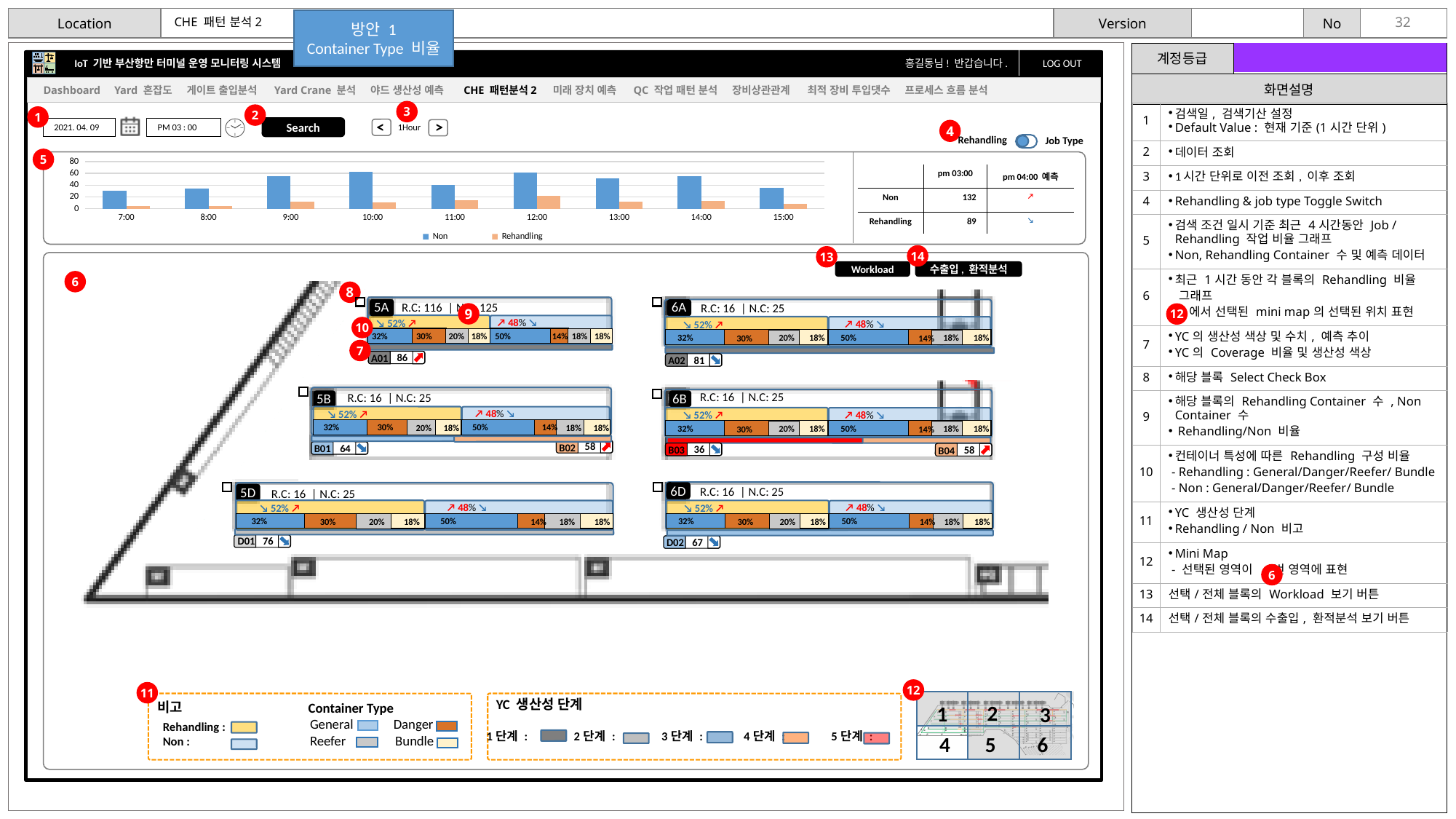
In the top bar chart, is the Non value at 7:00 greater or less than 40? less In the top bar chart, is the Non value at 10:00 greater or less than 40? greater How many series does the legend of the top bar chart list? 2 How many time points are shown on the x axis of the top bar chart? 9 What kind of chart is shown in the top panel of the dashboard (item 5)? bar chart What are the two series named in the legend of the top bar chart? Non and Rehandling In the top bar chart, is the Rehandling value at 12:00 greater or less than 40? less In the top bar chart, do the Non values rise or fall from 7:00 to 10:00? rise In the top bar chart, which is larger, the Rehandling bar at 12:00 or the Rehandling bar at 8:00? 12:00 In the top bar chart, which is larger at 12:00, the Non bar or the Rehandling bar? Non In the top bar chart, at which time is the Rehandling bar highest? 12:00